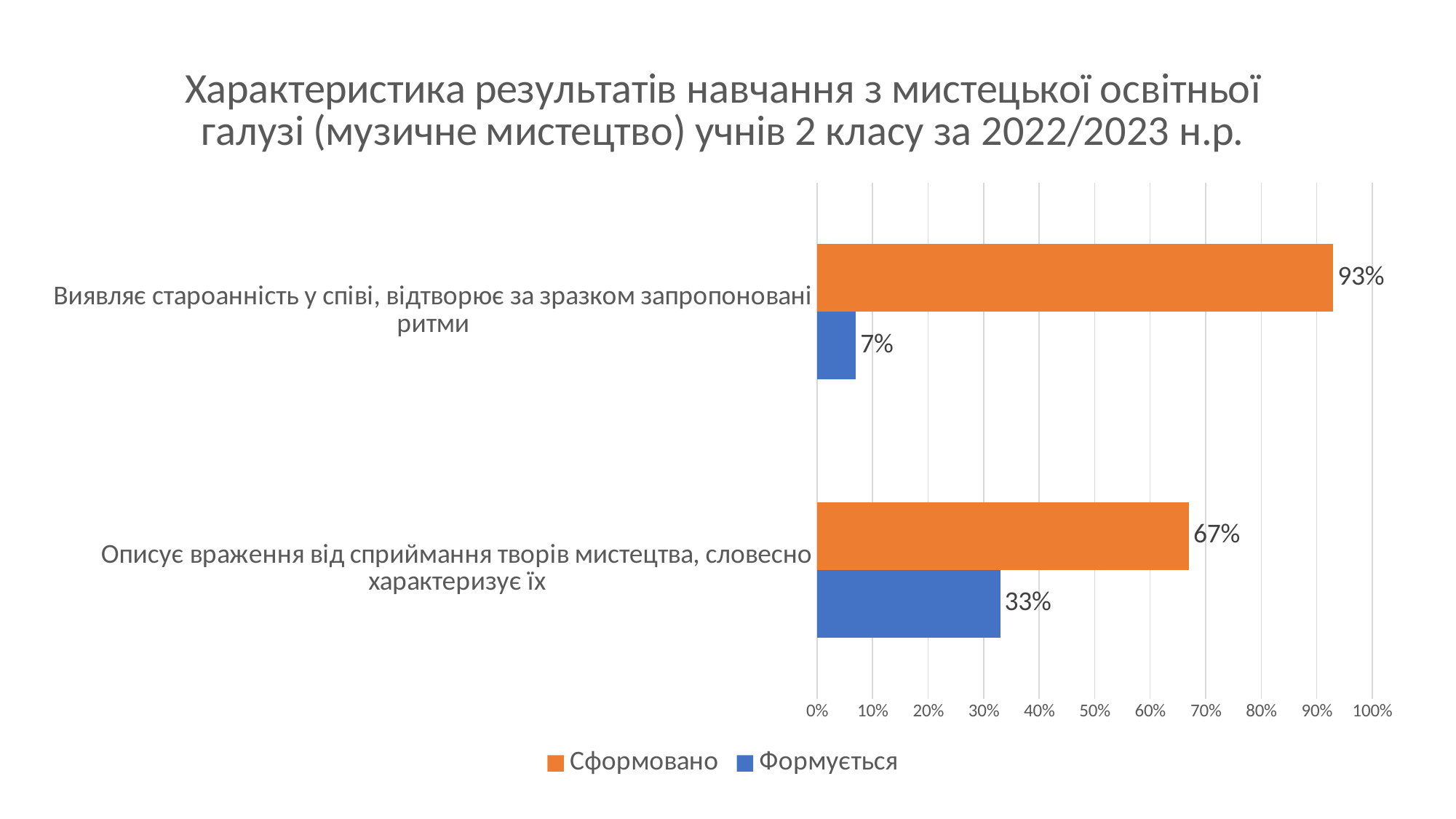
How many series does the legend list? 2 What is the value of "Формується" for "Виявляє староанність у співі, відтворює за зразком запропоновані ритми"? 7% What is the value of "Сформовано" for "Виявляє староанність у співі, відтворює за зразком запропоновані ритми"? 93% What is the difference between the "Сформовано" values of the two categories? 26% What is the value of "Сформовано" for "Описує враження від сприймання творів мистецтва, словесно характеризує їх"? 67% Which is larger: "Формується" for "Описує враження від сприймання творів мистецтва, словесно характеризує їх" or "Формується" for "Виявляє староанність у співі, відтворює за зразком запропоновані ритми"? Описує враження від сприймання творів мистецтва, словесно характеризує їх What is the value of "Формується" for "Описує враження від сприймання творів мистецтва, словесно характеризує їх"? 33% Which category has the lowest "Формується" value? Виявляє староанність у співі, відтворює за зразком запропоновані ритми How many categories are shown on the chart? 2 What kind of chart is shown on the slide? Bar chart What is the difference between "Сформовано" and "Формується" for "Описує враження від сприймання творів мистецтва, словесно характеризує їх"? 34% Which category has the highest "Сформовано" value? Виявляє староанність у співі, відтворює за зразком запропоновані ритми